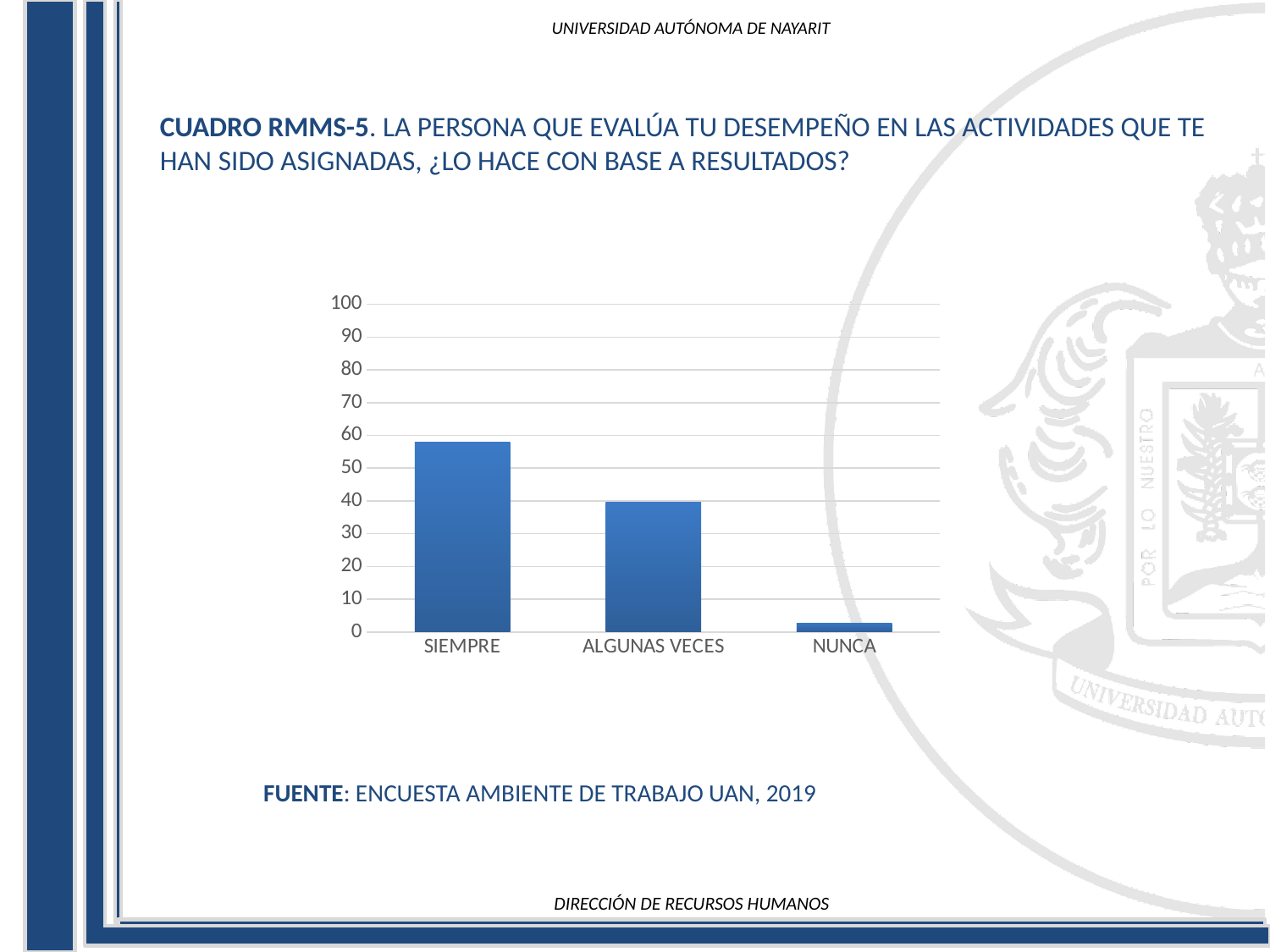
What is the highest value shown on the vertical axis of the chart? 100 What kind of chart is shown on the slide? bar chart Which category has the highest bar in the chart? SIEMPRE How many categories are shown on the x axis of the chart? 3 Is the value for SIEMPRE greater or less than 50? greater Is the value for ALGUNAS VECES greater or less than 50? less Which is larger, the value for SIEMPRE or the value for ALGUNAS VECES? SIEMPRE Which category has the lowest bar in the chart? NUNCA Do the bar values rise or fall from left to right across the x axis? fall Is the value for NUNCA greater or less than 10? less Which is larger, the value for ALGUNAS VECES or the value for NUNCA? ALGUNAS VECES